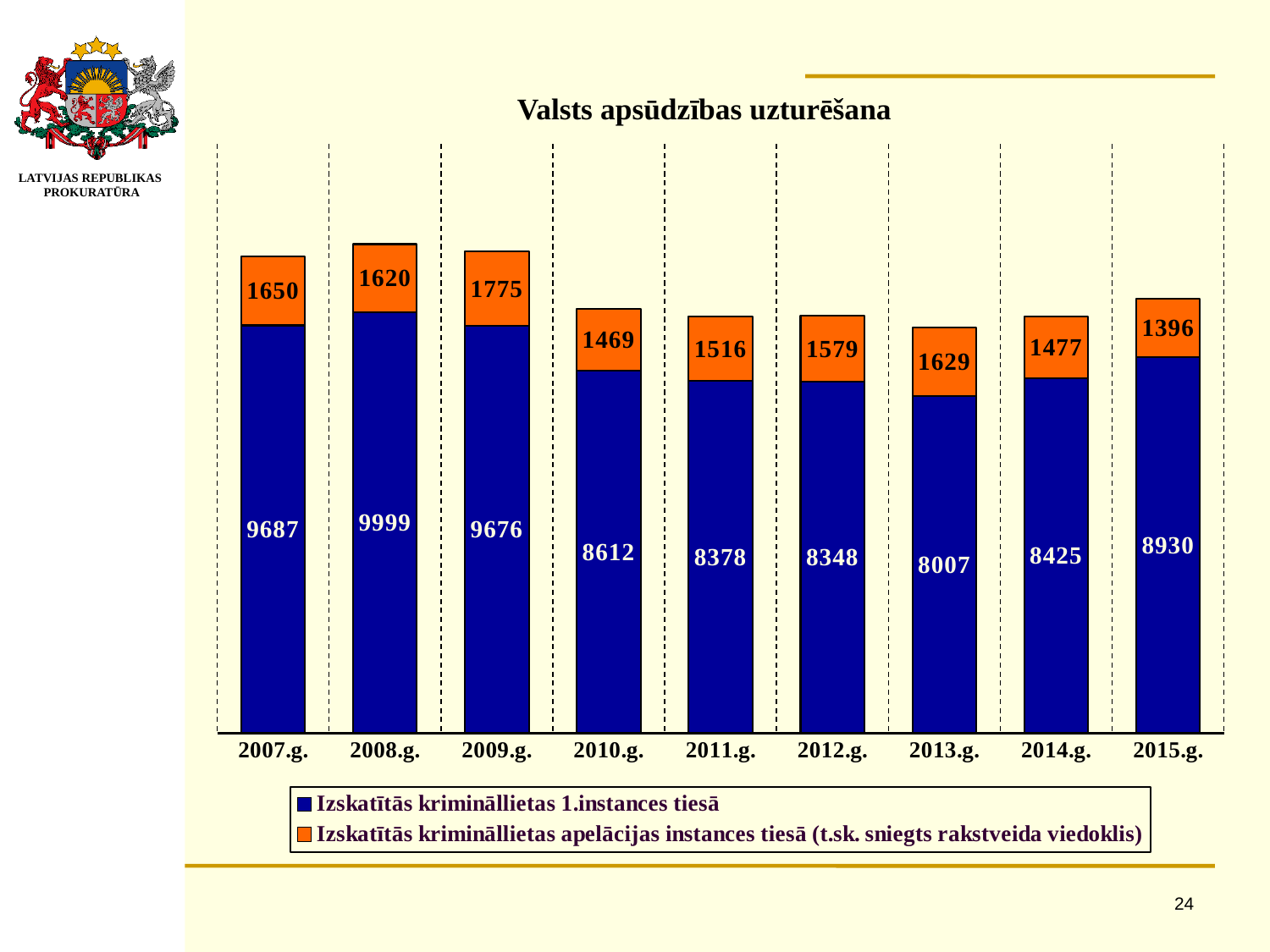
Which year has the highest value for 'Izskatītās krimināllietas 1.instances tiesā'? 2008.g. What is the total of the stacked bar for 2015.g.? 10326 Which year has the highest value for 'Izskatītās krimināllietas apelācijas instances tiesā (t.sk. sniegts rakstveida viedoklis)'? 2009.g. What kind of chart is shown on the slide? Stacked bar chart How many years are shown on the x axis? 9 What is the value for 'Izskatītās krimināllietas apelācijas instances tiesā (t.sk. sniegts rakstveida viedoklis)' in 2013.g.? 1629 Which year has the lowest value for 'Izskatītās krimināllietas 1.instances tiesā'? 2013.g. What is the value for 'Izskatītās krimināllietas 1.instances tiesā' in 2008.g.? 9999 How many series does the legend list? 2 Which year has the lowest value for 'Izskatītās krimināllietas apelācijas instances tiesā (t.sk. sniegts rakstveida viedoklis)'? 2015.g. Which is larger: the 'Izskatītās krimināllietas 1.instances tiesā' value for 2014.g. or for 2011.g.? 2014.g. What is the difference between the 'Izskatītās krimināllietas 1.instances tiesā' values for 2008.g. and 2007.g.? 312